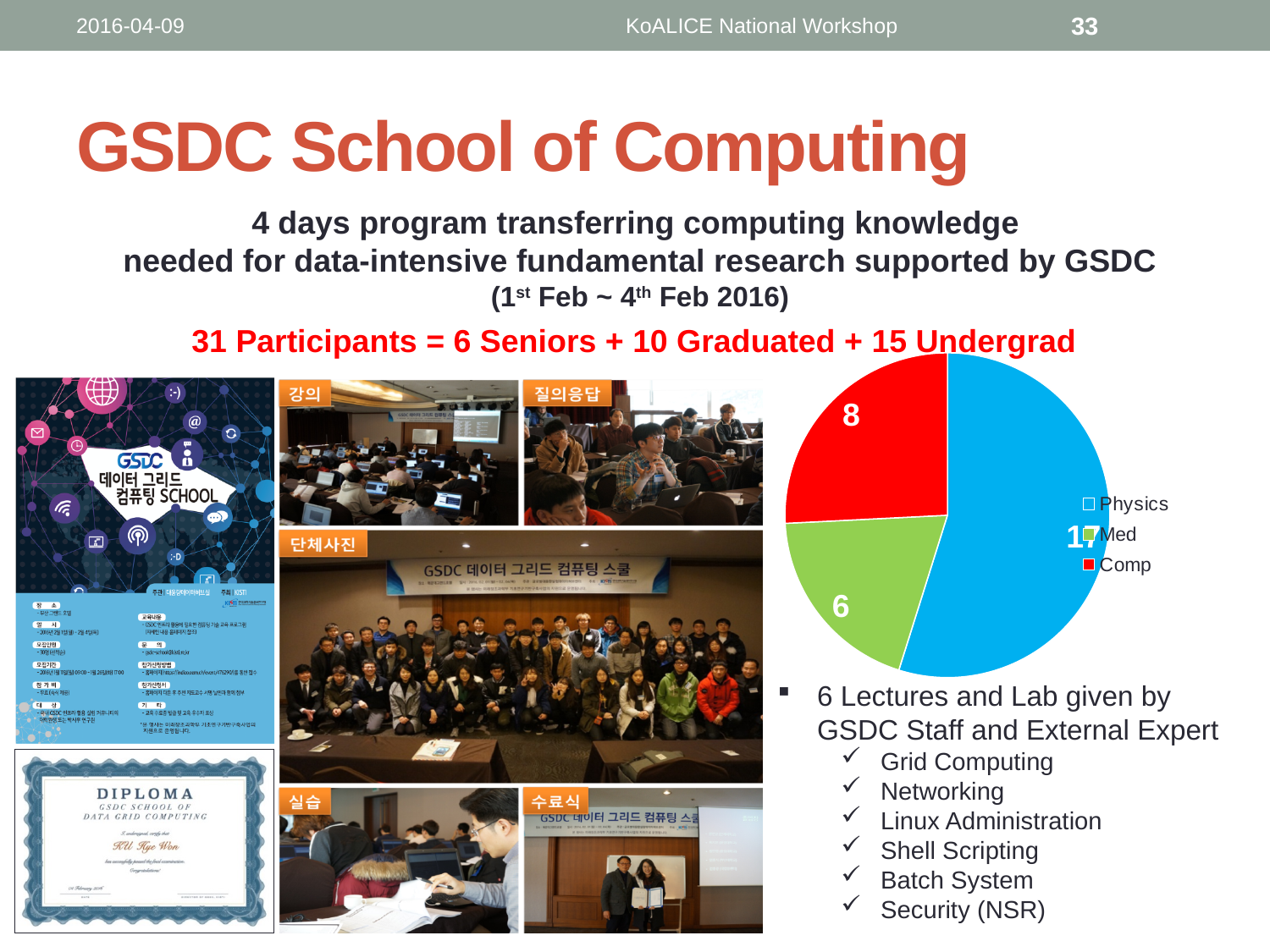
Which colour represents Physics in the pie chart? blue Which category has the largest slice in the pie chart? Physics How many slices does the pie chart have? 3 What kind of chart is shown on the slide? pie chart What is the difference between the Comp and Med values in the pie chart? 2 Which colour represents Comp in the pie chart? red What is the value shown for the Med slice of the pie chart? 6 What is the value shown for the Comp slice of the pie chart? 8 What is the value shown for the Physics slice of the pie chart? 17 Which is larger in the pie chart, Comp or Med? Comp How many entries does the legend of the pie chart list? 3 Which category has the smallest slice in the pie chart? Med